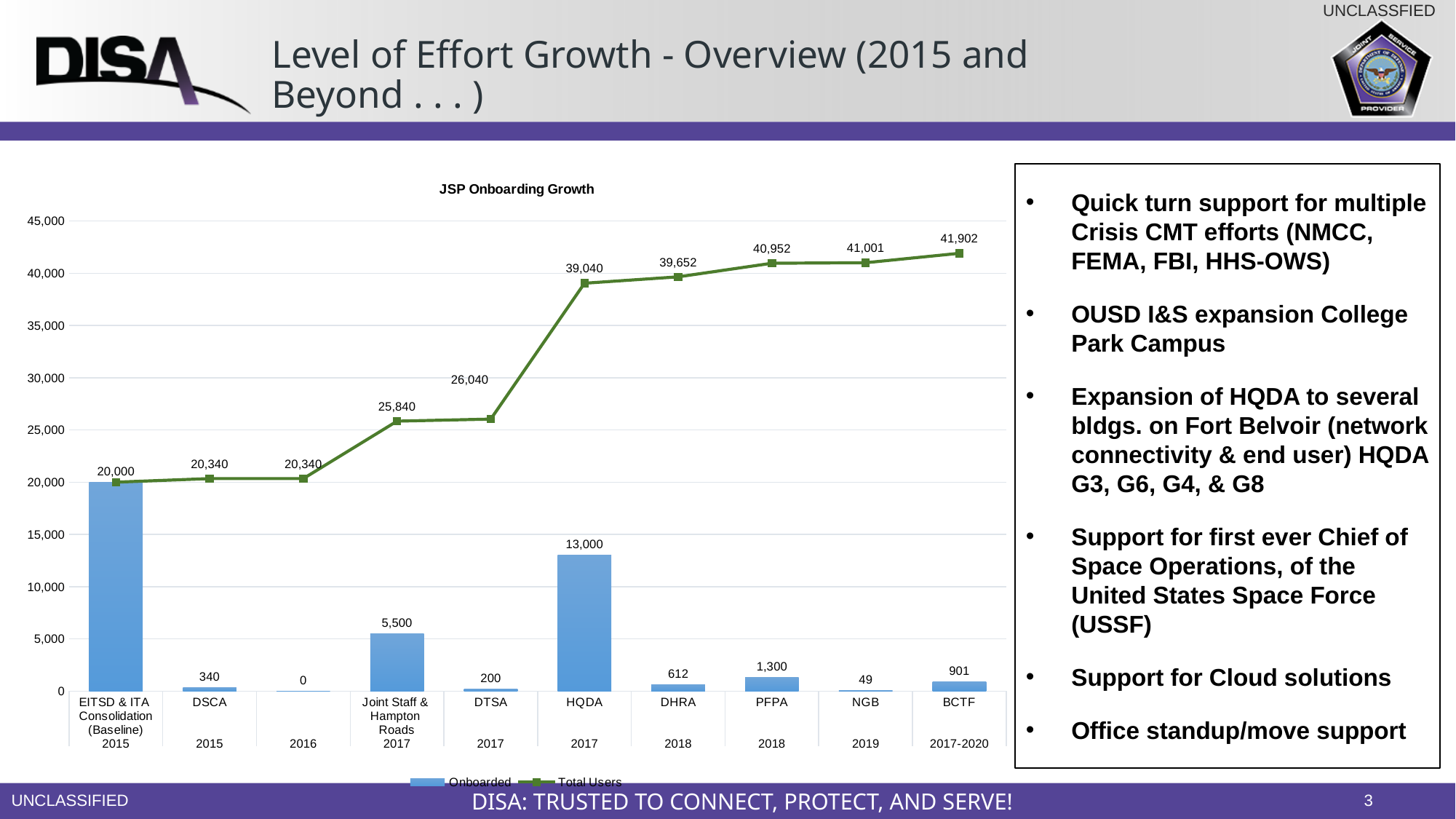
Which has a larger Onboarded value, PFPA or DHRA? PFPA What kind of chart is shown? Combined bar and line chart What is the Total Users value at BCTF? 41,902 Does the Total Users line rise or fall from left to right? Rise Is the Total Users value at DTSA greater or less than 25,000? greater How many series does the legend list? 2 What is the Onboarded value for Joint Staff & Hampton Roads? 5,500 What is the title of the chart? JSP Onboarding Growth What is the Onboarded value for HQDA? 13,000 What is the difference between the Total Users values at HQDA and at Joint Staff & Hampton Roads? 13,200 Which labelled category has the lowest non-zero Onboarded value? NGB Which category has the highest Onboarded value? EITSD & ITA Consolidation (Baseline)